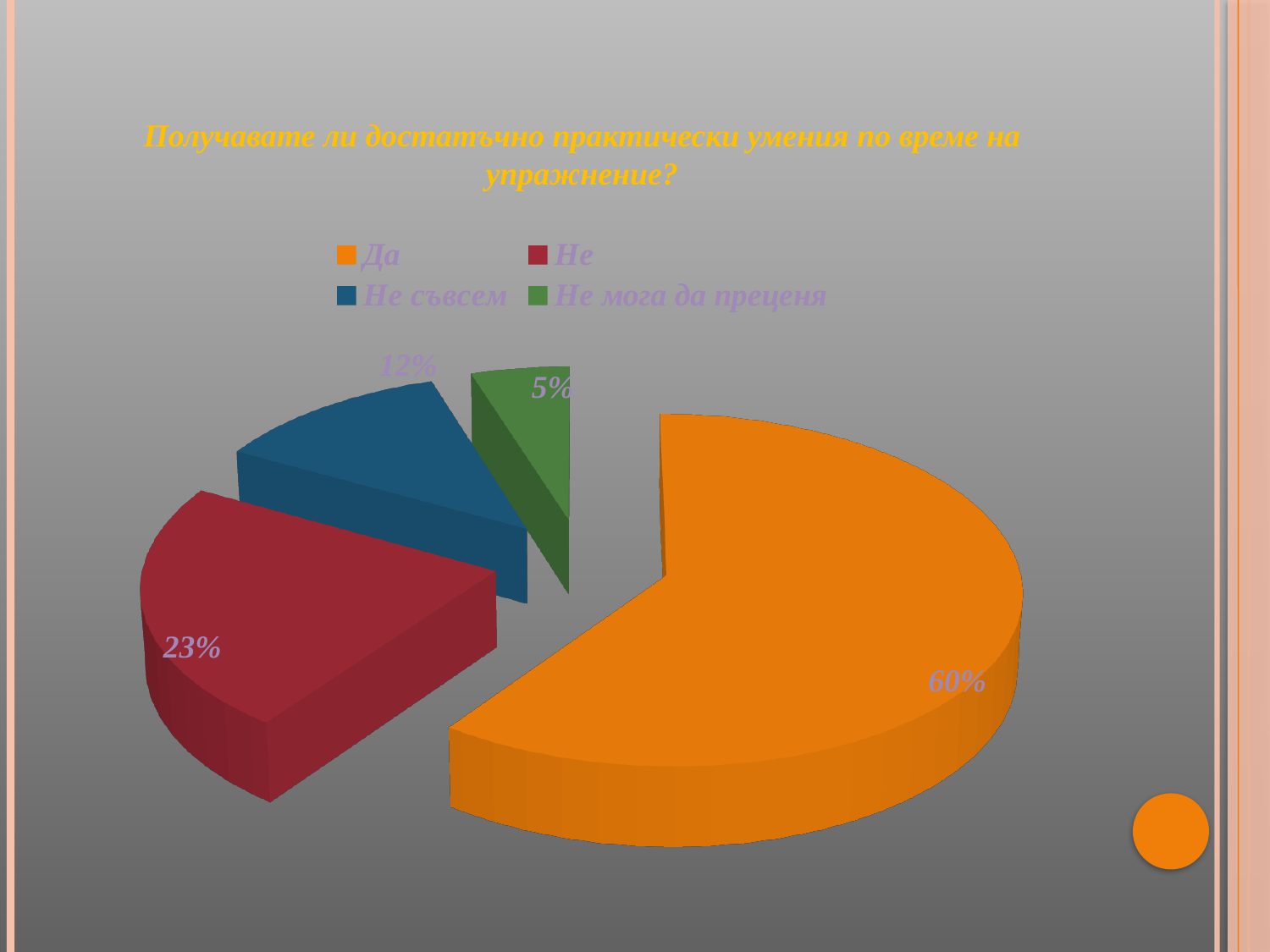
What colour is the slice for "Не съвсем"? blue What share of the pie does "Не мога да преценя" have? 5% What kind of chart is shown on the slide? pie chart Which is larger, the slice for "Не" or the slice for "Не съвсем"? Не What is the difference in percentage points between "Да" and "Не"? 37 How many categories does the pie chart have? 4 What share of the pie does "Не съвсем" have? 12% What share of the pie does "Да" have? 60% Which category has the smallest slice of the pie? Не мога да преценя Which category has the largest slice of the pie? Да What is the title of the chart? Получавате ли достатъчно практически умения по време на упражнение?